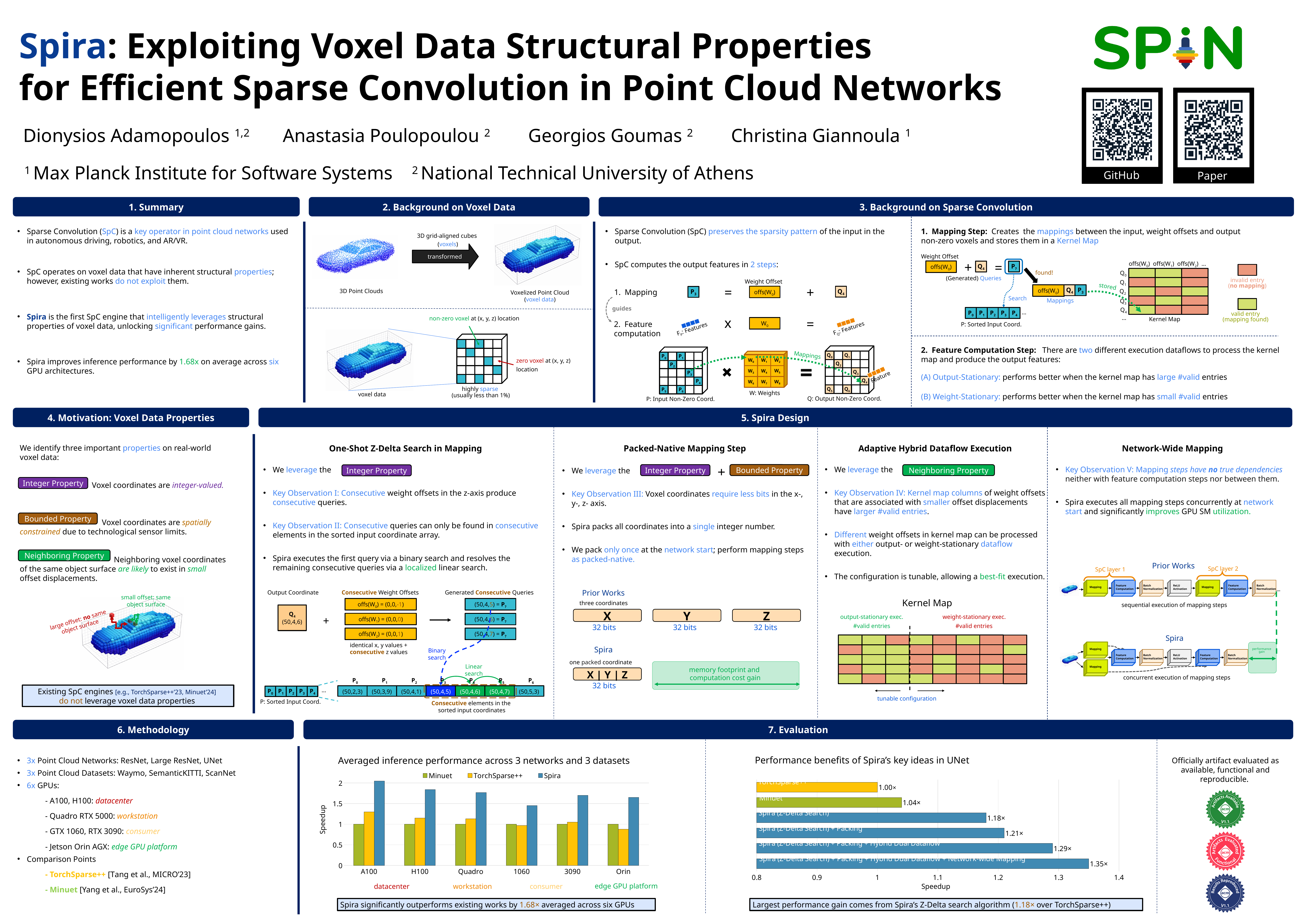
In the chart titled 'Averaged inference performance across 3 networks and 3 datasets', is the Spira speedup for A100 greater or less than 2? greater In the chart titled 'Performance benefits of Spira's key ideas in UNet', what kind of chart is used? Bar chart In the chart titled 'Performance benefits of Spira's key ideas in UNet', what is the speedup value for the bar labelled Spira (Z-Delta Search) + Packing + Hybrid Dual Dataflow + Network-wide Mapping? 1.35× In the chart titled 'Performance benefits of Spira's key ideas in UNet', what is the speedup value for Spira (Z-Delta Search)? 1.18× In the chart titled 'Performance benefits of Spira's key ideas in UNet', how many bars are plotted? 6 In the chart titled 'Averaged inference performance across 3 networks and 3 datasets', which is larger for the 1060 GPU: the Spira bar or the TorchSparse++ bar? Spira In the chart titled 'Averaged inference performance across 3 networks and 3 datasets', how many series does the legend list? 3 In the chart titled 'Performance benefits of Spira's key ideas in UNet', which bar has the highest speedup? Spira (Z-Delta Search) + Packing + Hybrid Dual Dataflow + Network-wide Mapping In the chart titled 'Performance benefits of Spira's key ideas in UNet', what is the speedup value for Minuet? 1.04× In the chart titled 'Performance benefits of Spira's key ideas in UNet', what is the difference between the speedup of Spira (Z-Delta Search) + Packing and Spira (Z-Delta Search)? 0.03× In the chart titled 'Averaged inference performance across 3 networks and 3 datasets', how many GPU categories are shown on the x axis? 6 In the chart titled 'Averaged inference performance across 3 networks and 3 datasets', which GPU has the highest Spira speedup? A100